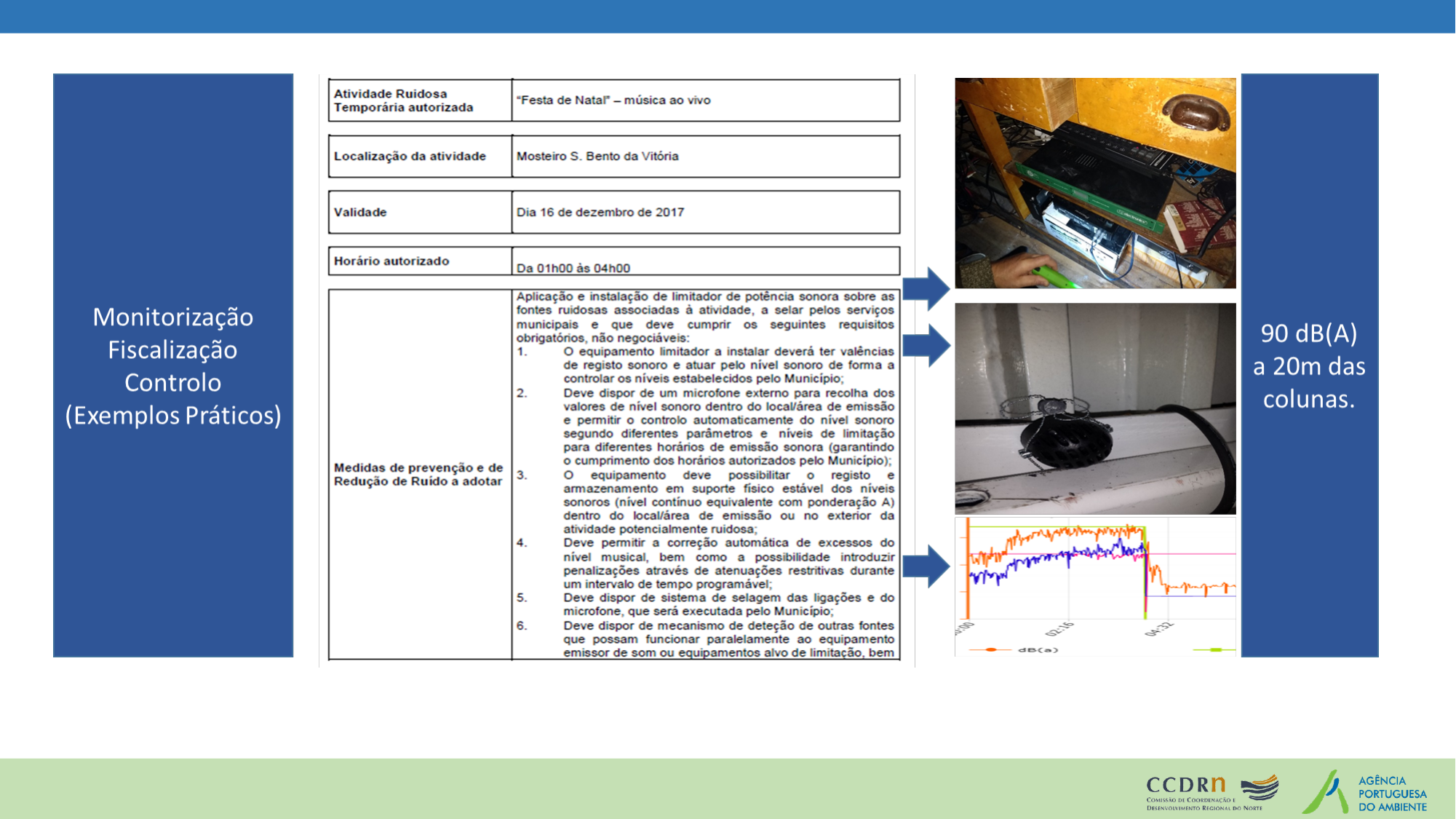
What kind of chart is shown at the bottom right of the slide? line chart In the chart at the bottom right, what colour is the dB(a) series in the legend? orange In the chart at the bottom right, what series name is readable in the legend? dB(a) In the chart at the bottom right, does the orange dB(a) line rise or fall sharply just before the 04:32 tick? fall In the chart at the bottom right, which x-axis tick label comes after 02:16? 04:32